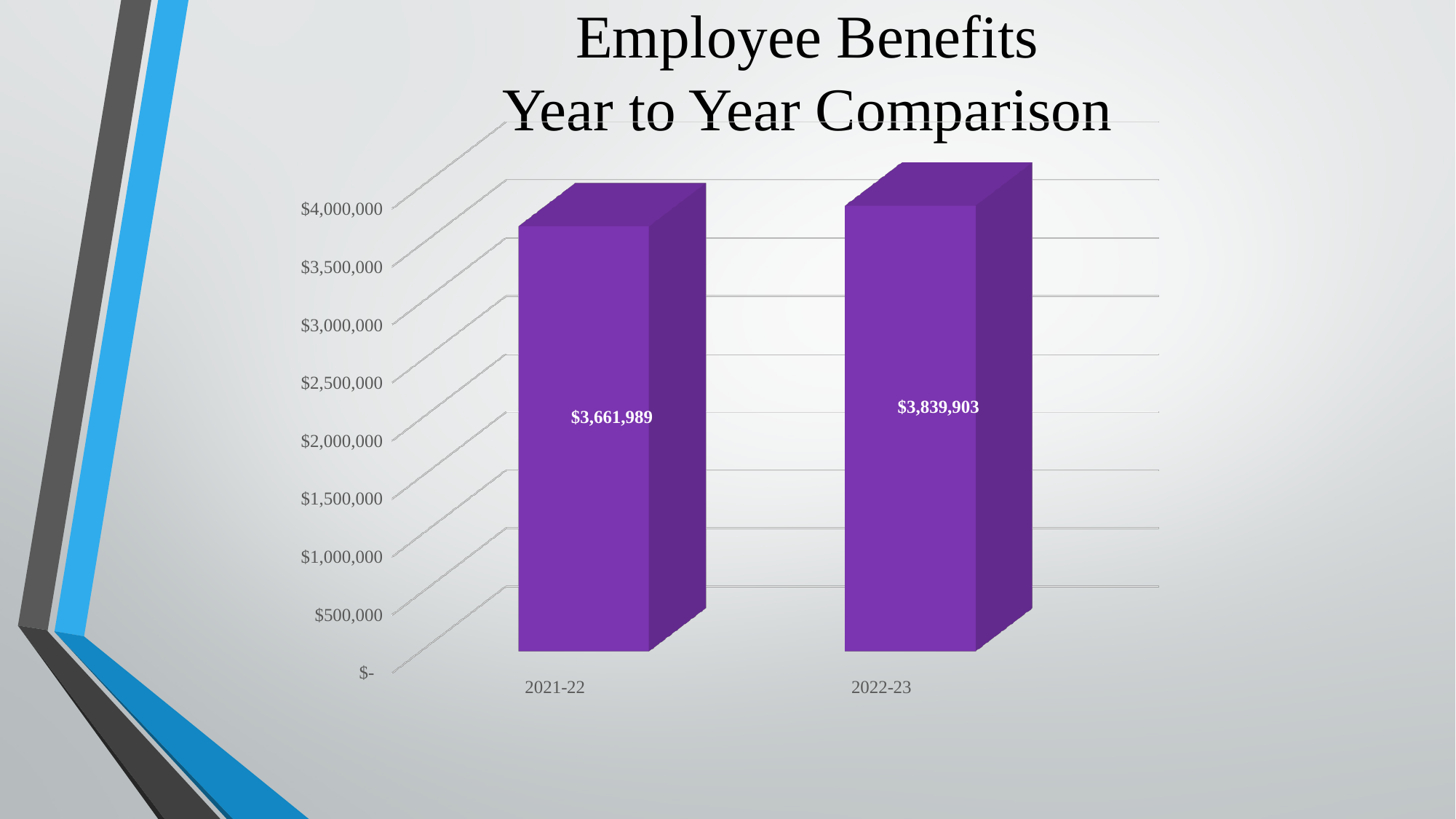
Which year has the lowest employee benefits value? 2021-22 What is the value for 2022-23? $3,839,903 What is the difference between the 2022-23 and 2021-22 values? $177,914 How many categories are shown on the x axis? 2 What is the title of the chart? Employee Benefits Year to Year Comparison What is the value for 2021-22? $3,661,989 Which is larger, the value for 2021-22 or the value for 2022-23? 2022-23 Is the value for 2021-22 greater or less than $3,500,000? greater What kind of chart is shown on the slide? bar chart Which year has the highest employee benefits value? 2022-23 Do the values rise or fall from 2021-22 to 2022-23? rise Is the value for 2022-23 greater or less than $4,000,000? less